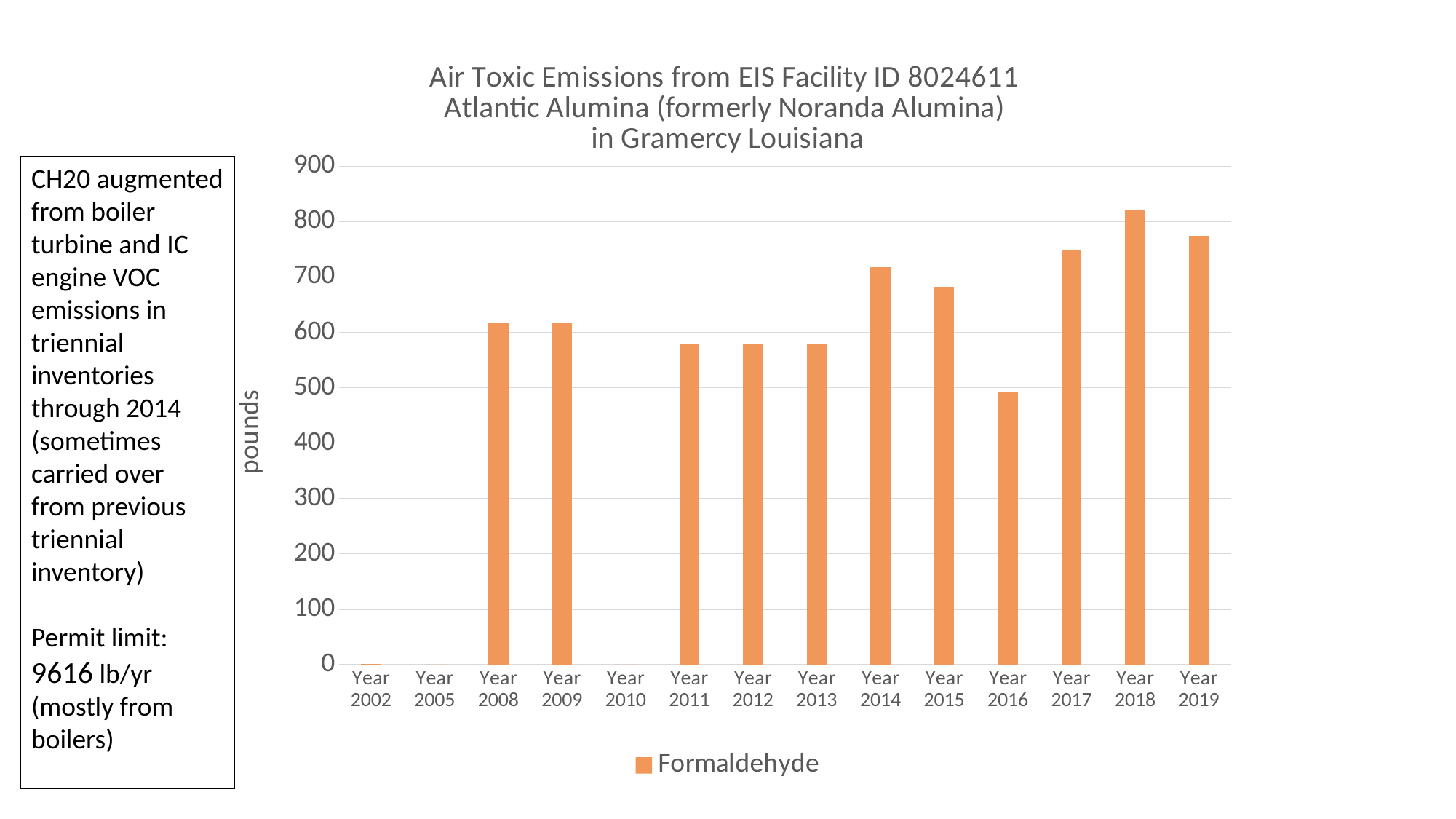
Is the value for Year 2011 greater or less than 600? less What is the label on the vertical axis? pounds What kind of chart is shown on the slide? bar chart Which is larger, the value for Year 2016 or the value for Year 2017? Year 2017 How many year categories are shown on the x axis? 14 How many series does the legend list? 1 Which is larger, the value for Year 2018 or the value for Year 2019? Year 2018 Is the value for Year 2008 greater or less than 600? greater Is the value for Year 2018 greater or less than 800? greater Which year has the highest formaldehyde emissions? Year 2018